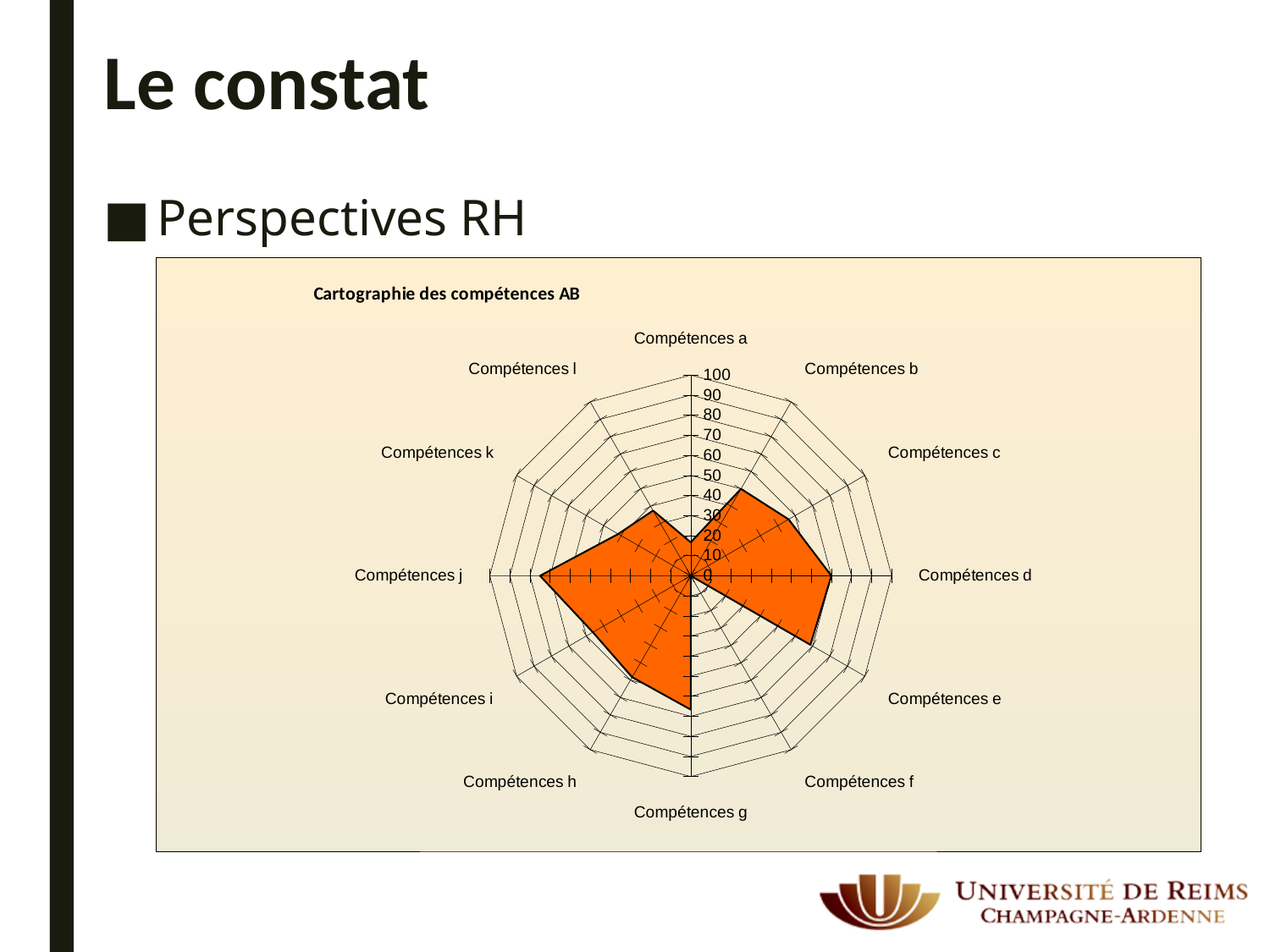
Is the value for Compétences a greater or less than 50? less How many competence categories are plotted on the radar chart? 12 What kind of chart is shown on the slide? radar chart What is the title of the chart? Cartographie des compétences AB Which has the larger value, Compétences d or Compétences a? Compétences d Which has the larger value, Compétences g or Compétences l? Compétences g Is the value for Compétences j greater or less than 50? greater Is the value for Compétences g greater or less than 50? greater What is the maximum value shown on the chart's axis scale? 100 Which has the larger value, Compétences j or Compétences f? Compétences j